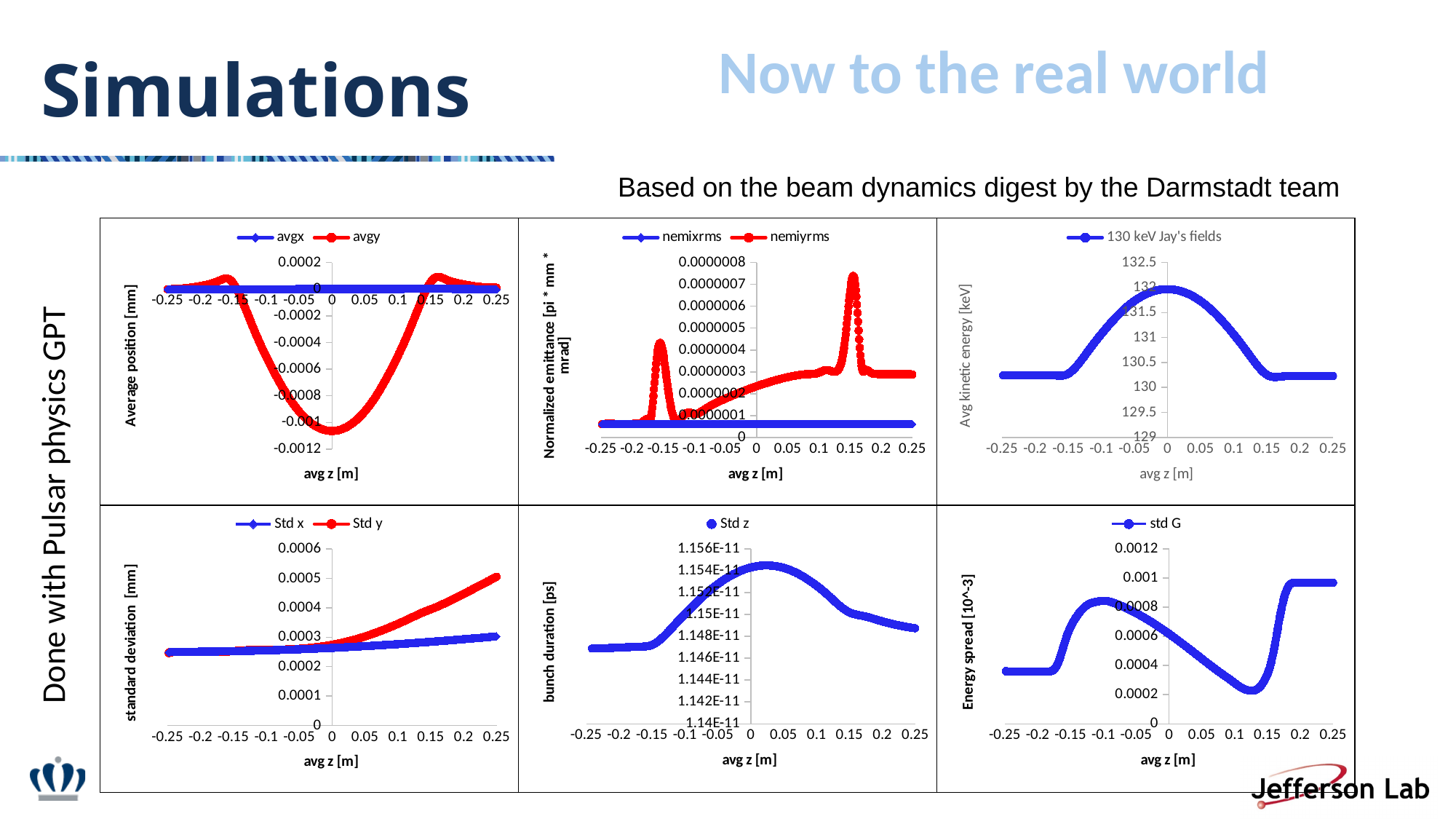
How many series does the legend of the top-left chart (avgx / avgy) list? 2 In the top-left chart (avgx / avgy), is the lowest avgy value greater or less than -0.0008? less In the top-middle chart (nemixrms / nemiyrms), which series has the larger value at avg z = 0.25? nemiyrms In the bottom-right chart (std G), is the value at avg z = 0.25 greater or less than 0.0008? greater In the bottom-right chart (std G), is the value at avg z = -0.25 greater or less than 0.0006? less In the top-right chart (130 keV Jay's fields), do the values rise or fall as avg z goes from -0.15 to 0? rise In the bottom-left chart (Std x / Std y), which series has the larger value at avg z = 0.25, Std x or Std y? Std y What is the y-axis title of the top-right chart (130 keV Jay's fields)? Avg kinetic energy [keV] What kind of chart is the bottom-middle chart (Std z)? scatter chart